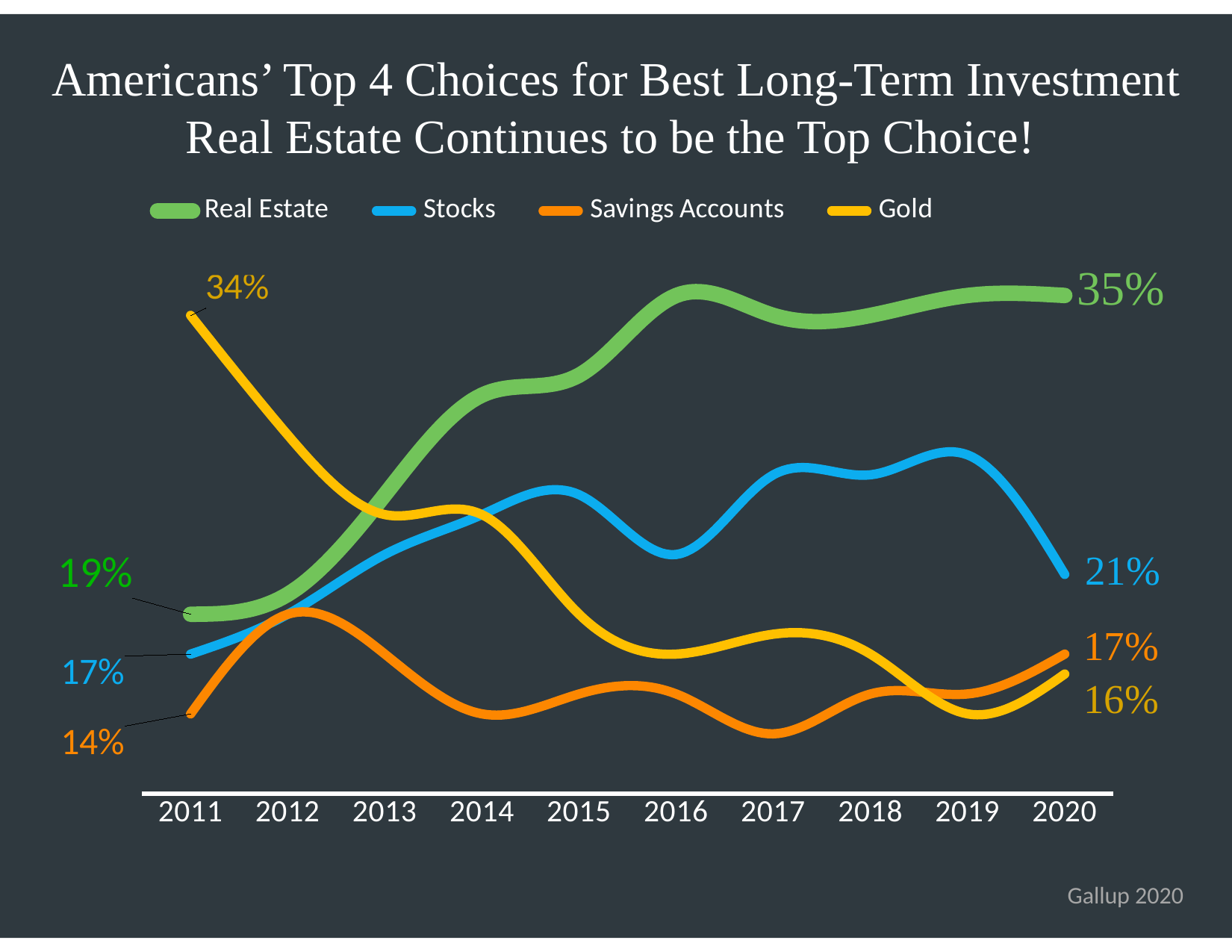
What was the value for Stocks in 2020? 21% What was the value for Gold in 2011? 34% Does the Gold line rise or fall from 2011 to 2020? fall In 2020, which is larger: the value for Stocks or the value for Savings Accounts? Stocks Which investment had the highest value in 2011? Gold Which investment had the lowest value in 2020? Gold What is the difference between the Real Estate value in 2020 and its value in 2011? 16% What was the value for Savings Accounts in 2011? 14% How many years are shown along the x axis? 10 What was the value for Real Estate in 2020? 35% What kind of chart is shown on the slide? line chart How many series does the legend list? 4